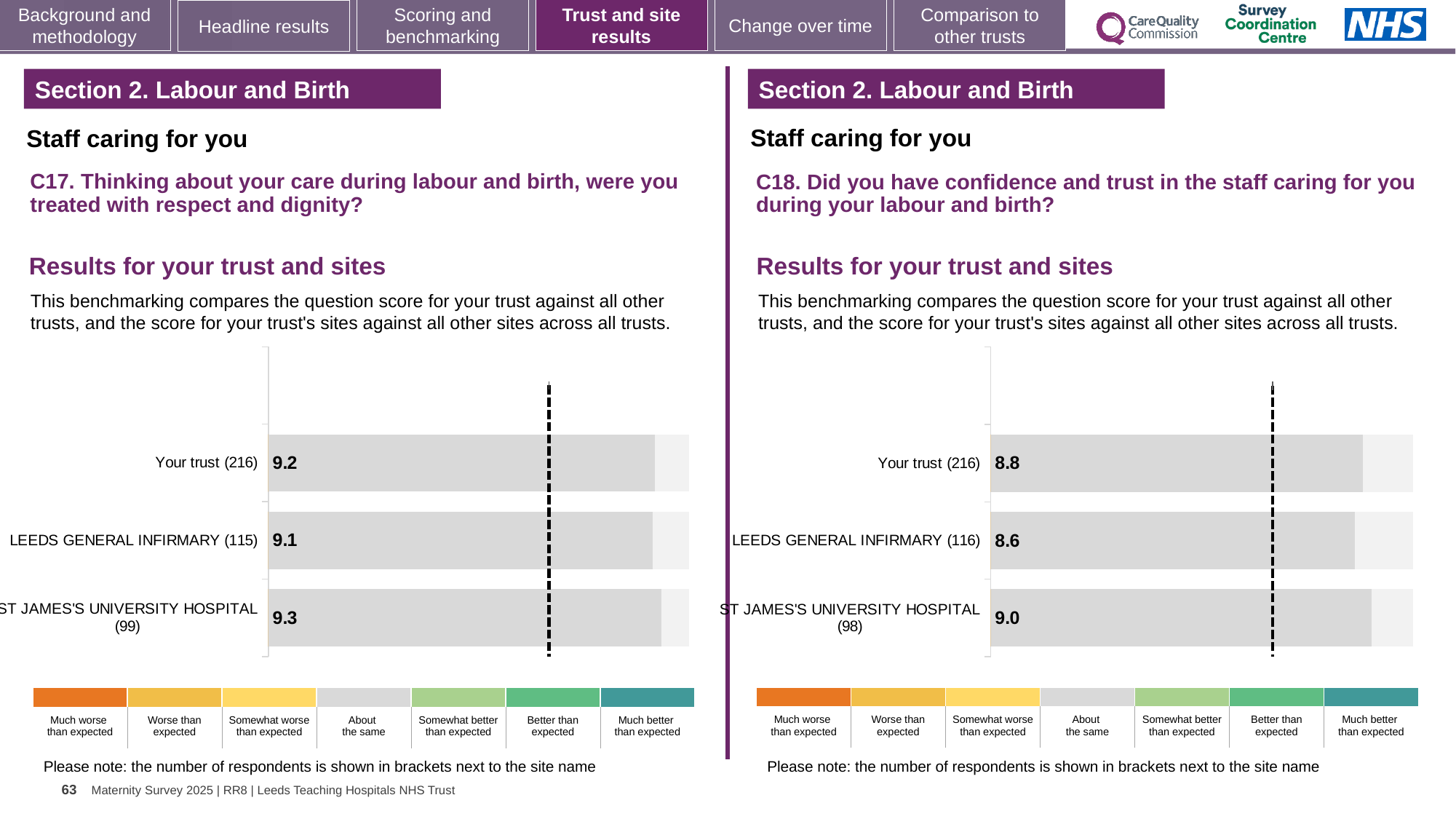
In the C17 chart on the left, how many respondents are shown in brackets for Leeds General Infirmary? 115 In the C17 chart on the left, what is the difference between the scores for St James's University Hospital and Leeds General Infirmary? 0.2 In the C18 chart on the right, what is the score for Your trust? 8.8 In the C18 chart on the right, which has the larger score: Your trust or Leeds General Infirmary? Your trust What type of chart is used for the C18 results on the right? Bar chart In the C17 chart on the left, which site or trust has the lowest score? Leeds General Infirmary In the C18 chart on the right, what is the difference between the scores for St James's University Hospital and Your trust? 0.2 In the C18 chart on the right, which site or trust has the highest score? St James's University Hospital How many bars are plotted in the C17 chart on the left? 3 In the C18 chart on the right, what is the score for Leeds General Infirmary? 8.6 In the C17 chart on the left, what is the score for St James's University Hospital? 9.3 In the C17 chart on the left, what is the score for Your trust? 9.2